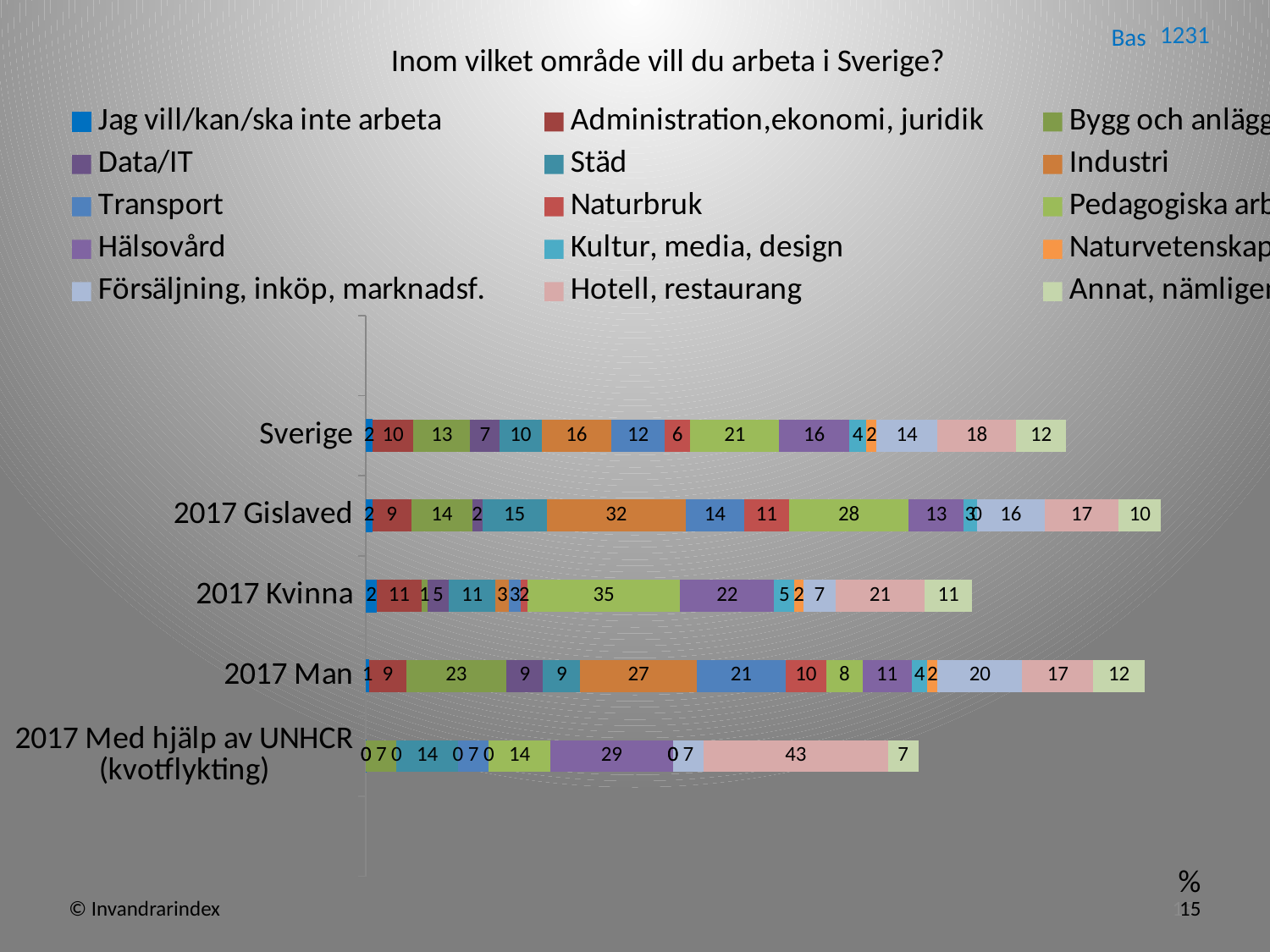
What is the difference between Hotell, restaurang and Annat, nämligen in the Sverige bar? 6 Which segment is the largest in the 2017 Med hjälp av UNHCR (kvotflykting) bar? Hotell, restaurang What kind of chart is shown on the slide? Stacked bar chart What is the value for Transport in the Sverige bar? 12 How many series does the legend list? 15 What is the value for Industri in the 2017 Man bar? 27 What is the value for Hotell, restaurang in the 2017 Med hjälp av UNHCR (kvotflykting) bar? 43 Which has a larger value for Industri, 2017 Man or 2017 Kvinna? 2017 Man What is the value for Industri in the 2017 Gislaved bar? 32 How many categories (bars) are shown on the chart? 5 What is the title of the chart? Inom vilket område vill du arbeta i Sverige? What is the value for Hälsovård in the 2017 Kvinna bar? 22